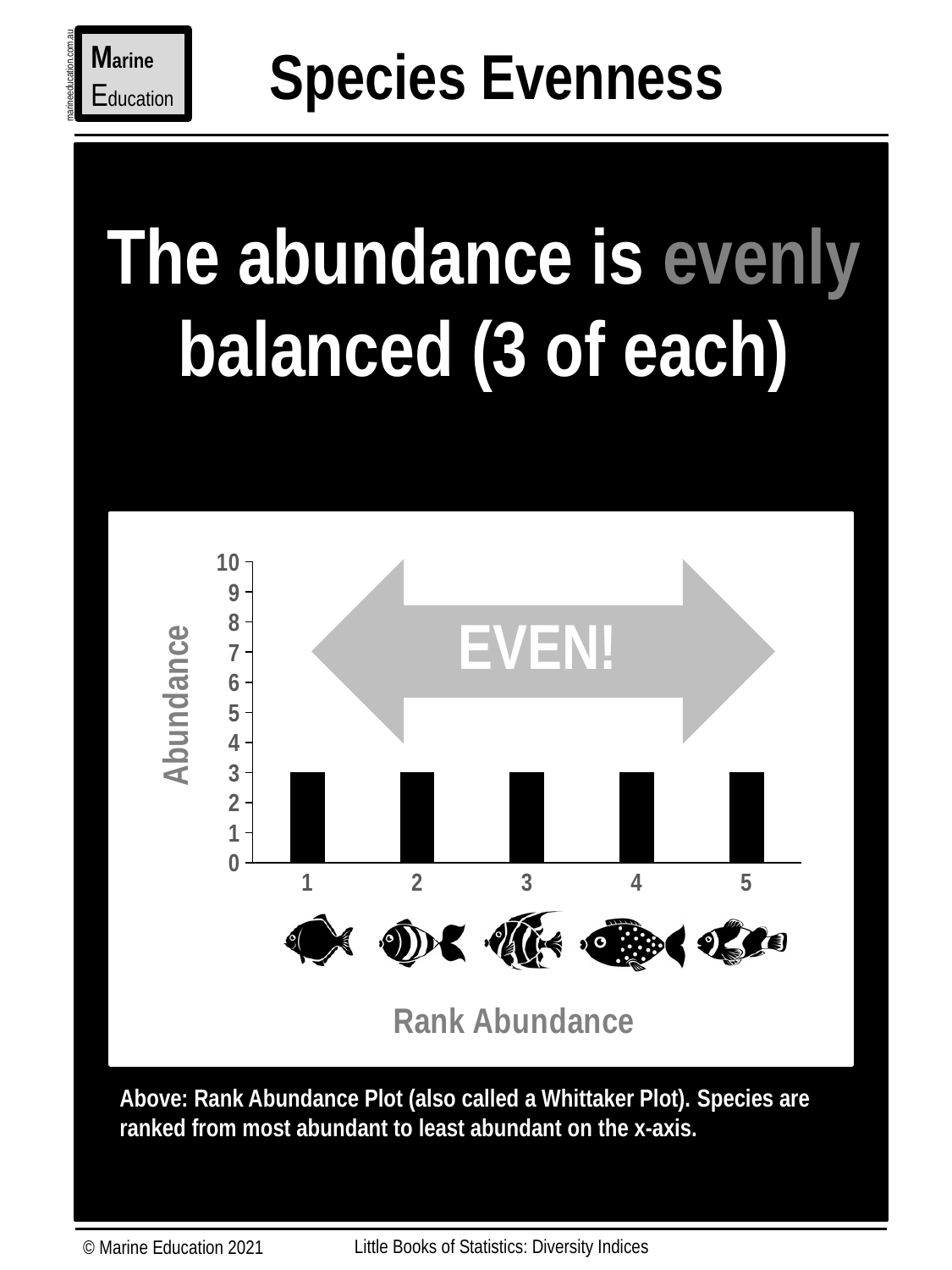
What is the abundance value for rank 3? 3 Do the abundance values rise, fall, or stay flat from rank 1 to rank 5? stay flat Is the abundance for rank 1 larger than, smaller than, or equal to the abundance for rank 4? equal What type of chart is shown on the slide? bar chart Is the abundance value for rank 2 greater or less than 5? less What is the abundance value for rank 5? 3 What is the abundance value for rank 1? 3 Is the abundance value for rank 4 greater or less than 2? greater What is the difference between the abundance values for rank 1 and rank 5? 0 What is the label of the y-axis of the chart? Abundance How many bars (ranked species) are plotted in the chart? 5 What is the label of the x-axis of the chart? Rank Abundance